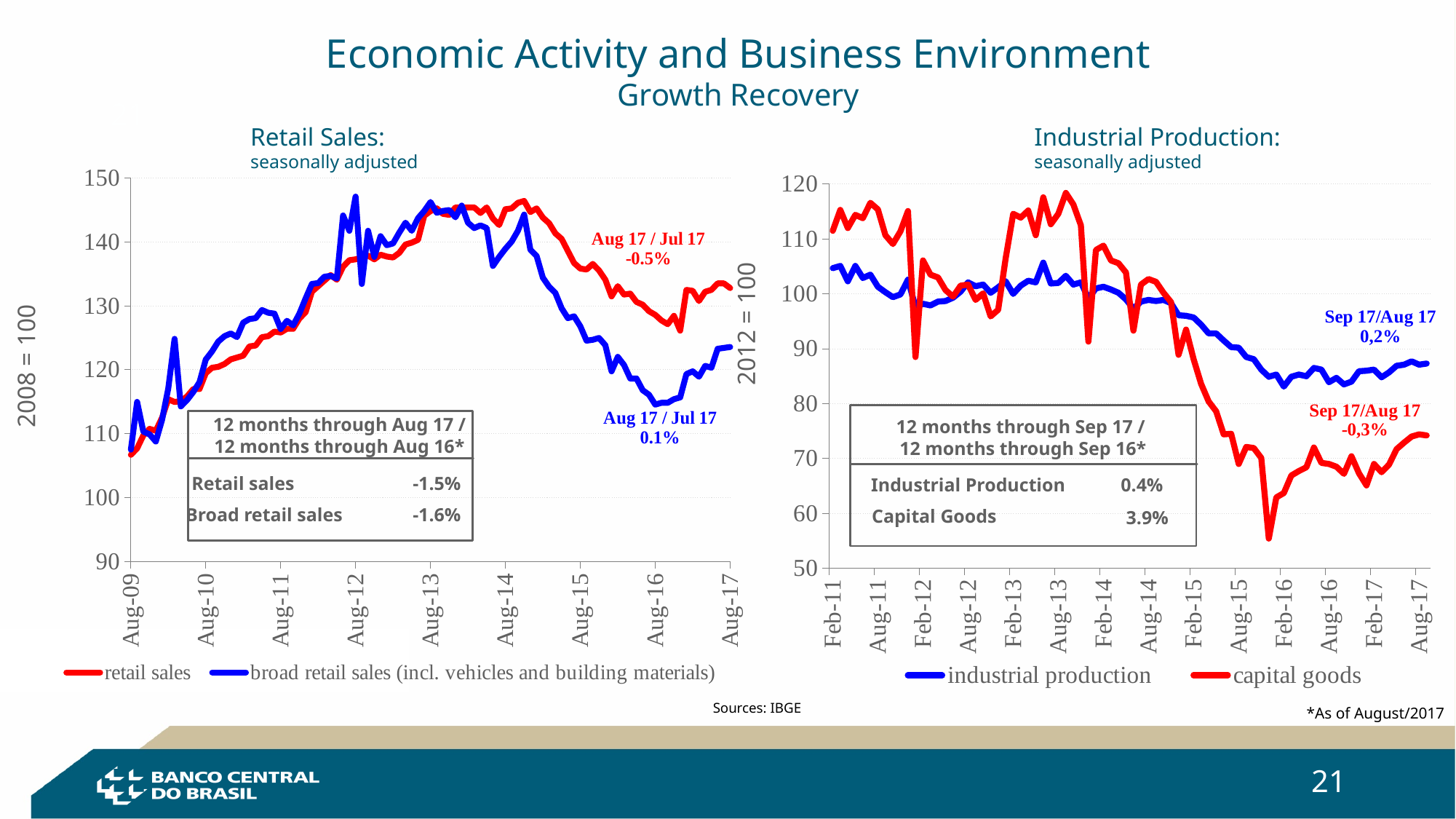
In the Retail Sales chart, is the value for retail sales at Aug-17 greater or less than 130? greater In the Industrial Production chart, what is the Sep 17/Aug 17 change annotated for industrial production? 0,2% In the Retail Sales chart, what is the Aug 17 / Jul 17 change annotated for retail sales? -0.5% In the Industrial Production chart, is the value for capital goods at Feb-16 greater or less than 60? greater In the Retail Sales chart, what is the Aug 17 / Jul 17 change annotated for broad retail sales? 0.1% In the Retail Sales chart, is the value for broad retail sales at Aug-16 greater or less than 120? less What type of chart is the Retail Sales chart? line chart How many series does the legend of the Industrial Production chart list? 2 In the Retail Sales chart, what is the 12 months through Aug 17 / 12 months through Aug 16 change shown for broad retail sales? -1.6% In the Industrial Production chart, does the capital goods series rise or fall between Aug-13 and Feb-16? fall In the Industrial Production chart, what is the Sep 17/Aug 17 change annotated for capital goods? -0,3%